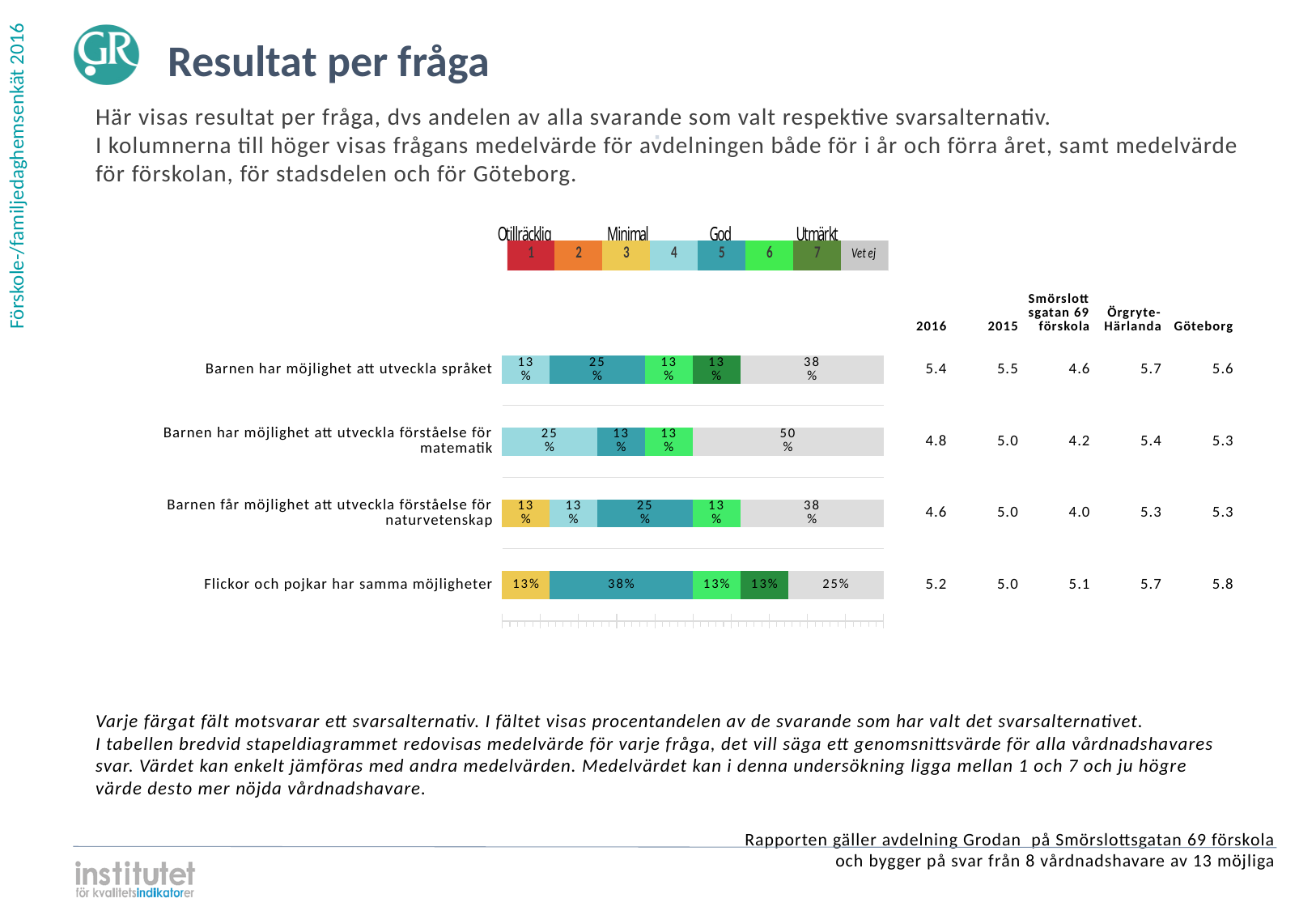
What percentage of respondents chose answer 5 (teal segment) for 'Flickor och pojkar har samma möjligheter'? 38% What is the Göteborg mean value for 'Flickor och pojkar har samma möjligheter'? 5.8 What is the difference between the 'Vet ej' share for 'Barnen har möjlighet att utveckla förståelse för matematik' and for 'Flickor och pojkar har samma möjligheter'? 25 percentage points How many answer alternatives does the legend above the chart show, including 'Vet ej'? 8 What percentage of respondents chose answer 7 (dark green segment) for 'Barnen har möjlighet att utveckla språket'? 13% How many questions (categories) are plotted in the bar chart? 4 Is the 'Vet ej' share larger for 'Barnen har möjlighet att utveckla språket' or for 'Flickor och pojkar har samma möjligheter'? Barnen har möjlighet att utveckla språket What percentage of respondents answered 'Vet ej' for 'Barnen har möjlighet att utveckla förståelse för matematik'? 50% Which question has the largest 'Vet ej' share? Barnen har möjlighet att utveckla förståelse för matematik What is the 2016 mean value for 'Barnen har möjlighet att utveckla språket'? 5.4 Which question has the smallest 'Vet ej' share? Flickor och pojkar har samma möjligheter What kind of chart is shown on the slide? Stacked bar chart